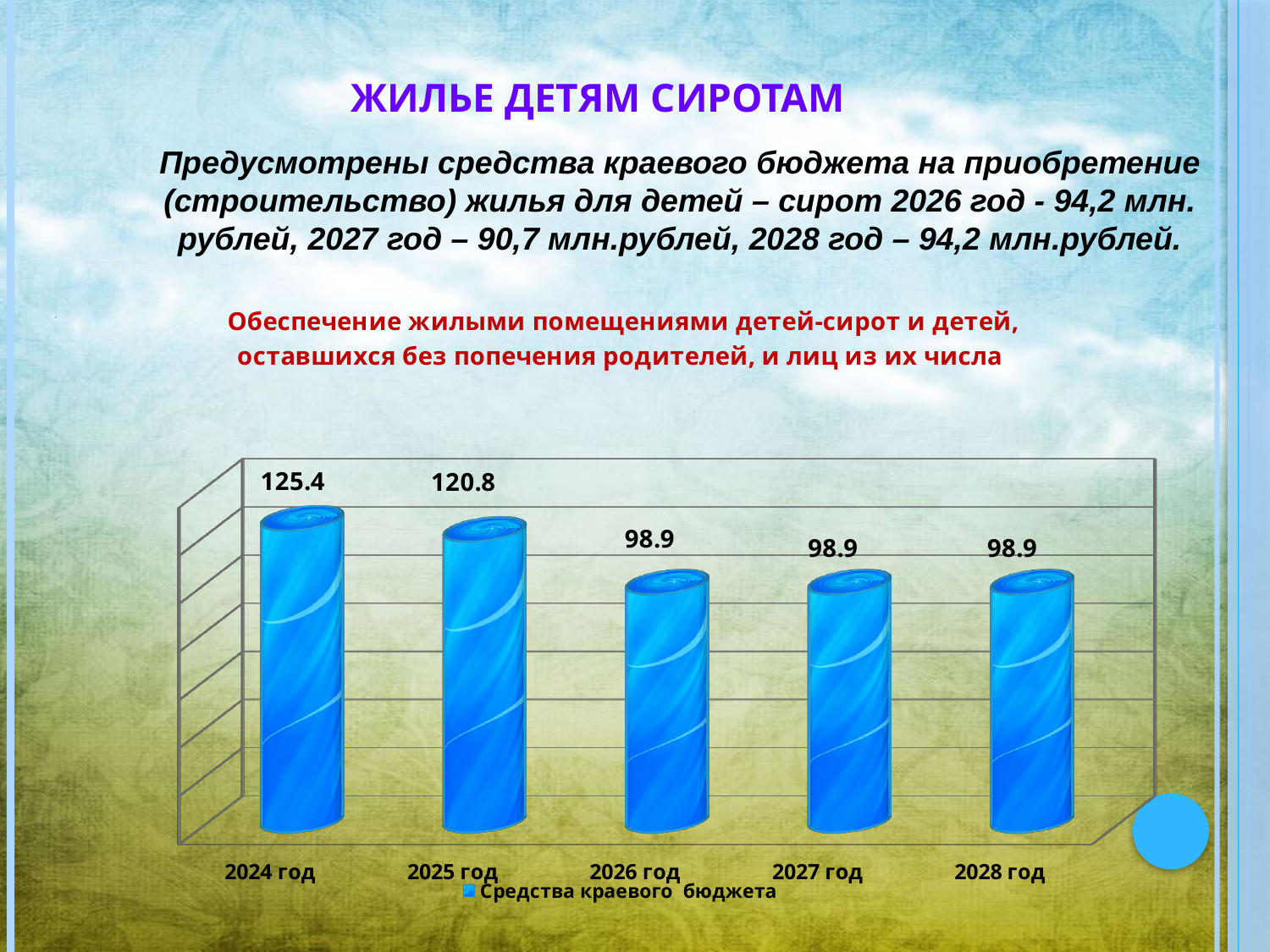
What is the difference between the values for 2025 год and 2026 год? 21.9 What is the value for 2024 год? 125.4 Which year has the highest value? 2024 год How many series does the legend list? 1 What is the lowest value shown on the chart? 98.9 Which is larger, the value for 2025 год or the value for 2028 год? 2025 год What is the name of the series in the legend? Средства краевого бюджета What is the value for 2025 год? 120.8 How many years are shown on the x axis? 5 What is the difference between the values for 2024 год and 2025 год? 4.6 What is the value for 2027 год? 98.9 What kind of chart is shown on the slide? Bar chart